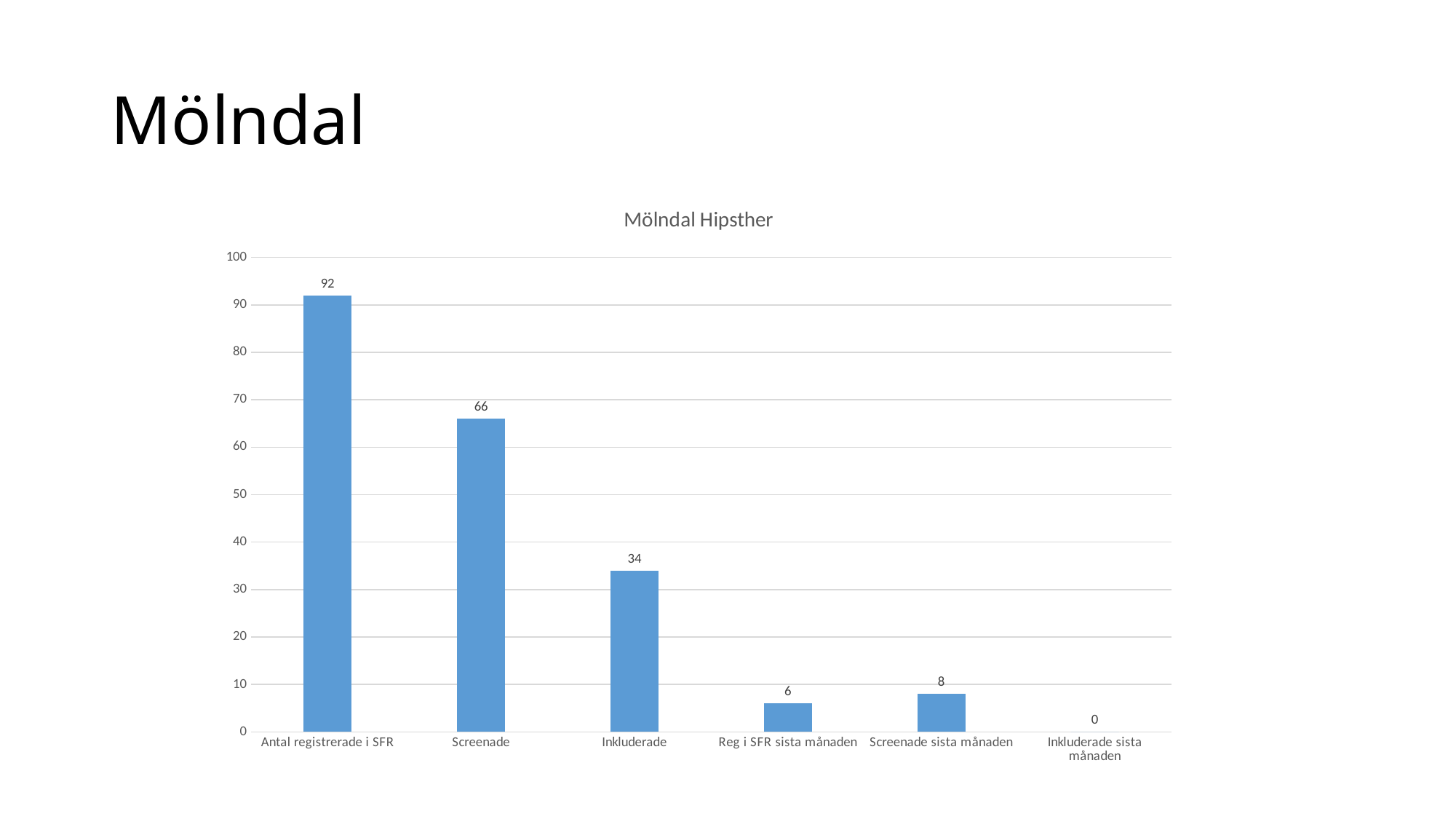
Which is larger, Reg i SFR sista månaden or Screenade sista månaden? Screenade sista månaden What is the title of the chart? Mölndal Hipsther Which category has the highest value? Antal registrerade i SFR What is the value for Inkluderade sista månaden? 0 Which category has the lowest value? Inkluderade sista månaden What kind of chart is this? Bar chart What is the difference between Screenade and Inkluderade? 32 How many categories are shown on the x axis? 6 What is the value for Antal registrerade i SFR? 92 What is the value for Screenade sista månaden? 8 What is the value for Screenade? 66 What is the value for Inkluderade? 34